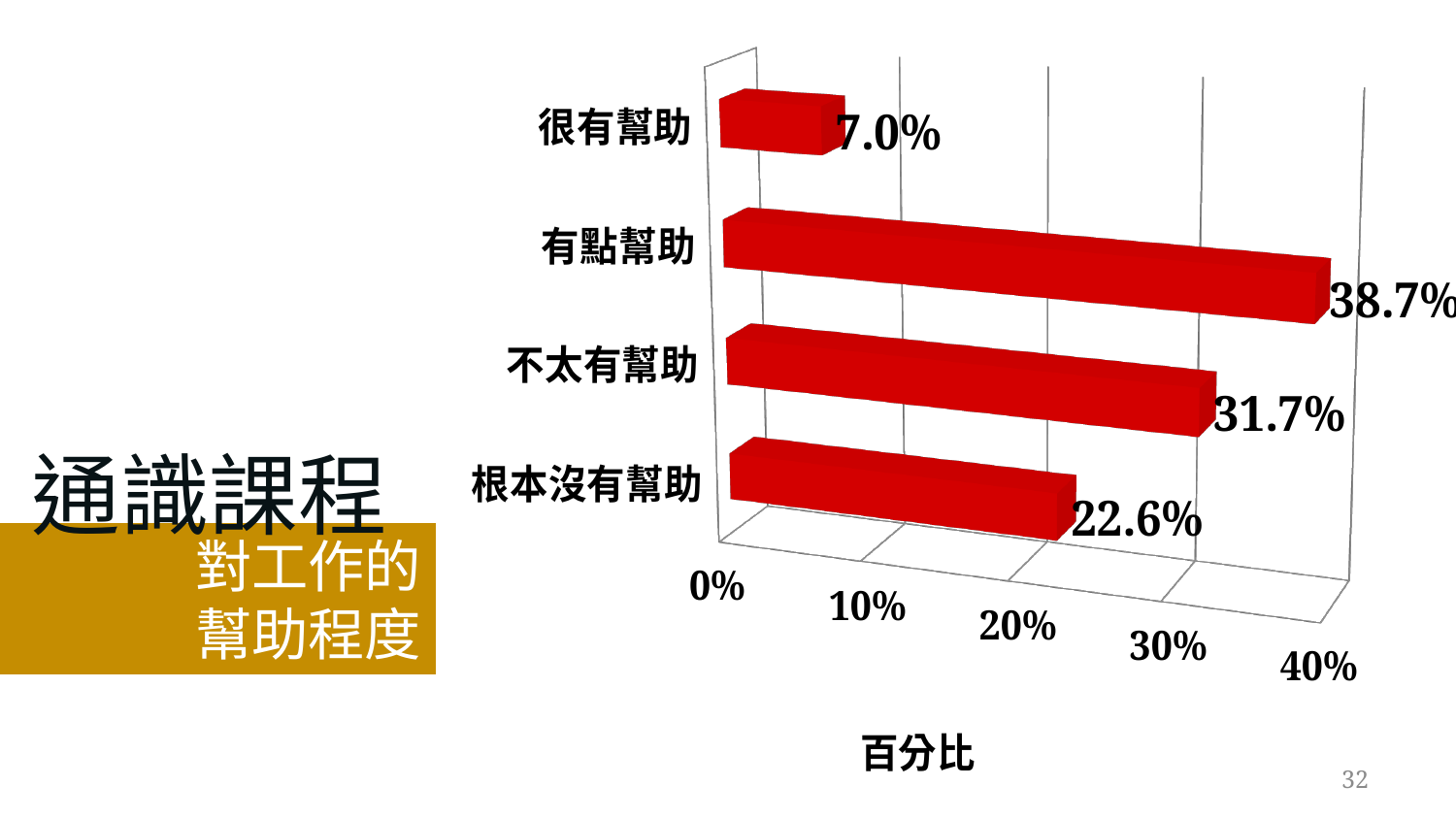
What is the difference between the values for 有點幫助 and 不太有幫助? 7.0% What is the value for 不太有幫助? 31.7% What is the value for 根本沒有幫助? 22.6% What is the label of the horizontal axis? 百分比 What kind of chart is shown on the slide? bar chart What is the value for 很有幫助? 7.0% Which is larger, the value for 不太有幫助 or the value for 根本沒有幫助? 不太有幫助 What is the difference between the values for 根本沒有幫助 and 很有幫助? 15.6% What is the value for 有點幫助? 38.7% Which category has the lowest value? 很有幫助 How many categories are shown in the chart? 4 Which category has the highest value? 有點幫助